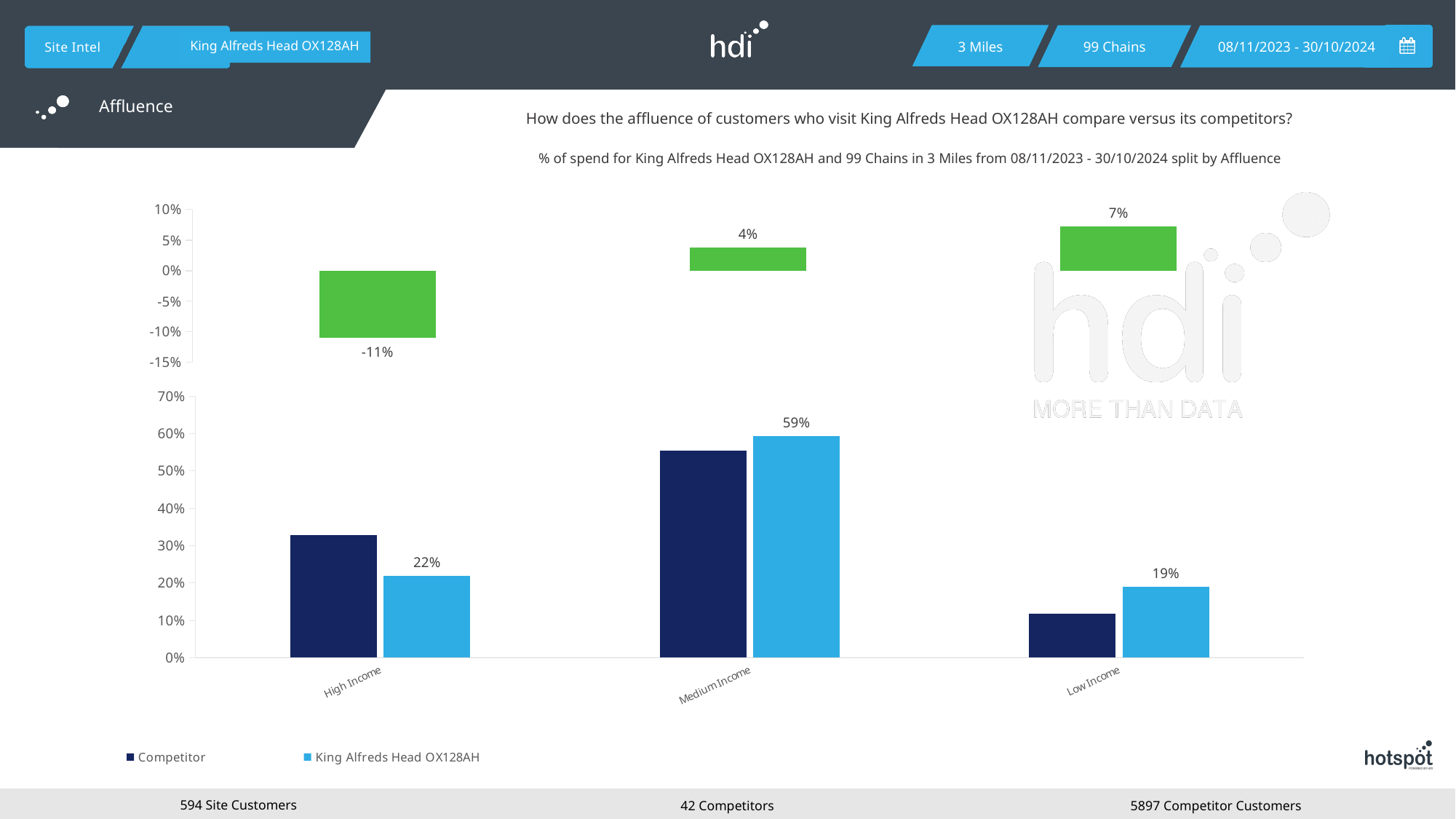
In the bottom bar chart, is the Competitor value for Low Income greater or less than 20%? less In the top chart of green bars, what is the value shown for the Low Income category? 7% How many series does the legend of the bottom bar chart list? 2 In the bottom bar chart, is the Competitor value for High Income greater or less than 30%? greater In the bottom bar chart, what is the difference between the King Alfreds Head OX128AH values for Medium Income and High Income? 37% In the bottom bar chart, what is the value for King Alfreds Head OX128AH in the Low Income category? 19% In the bottom bar chart, which is larger for High Income: the Competitor value or the King Alfreds Head OX128AH value? Competitor In the bottom bar chart, which category has the highest value for King Alfreds Head OX128AH? Medium Income In the top chart of green bars, what is the value shown for the High Income category? -11% In the bottom bar chart, what is the value for King Alfreds Head OX128AH in the High Income category? 22% In the top chart of green bars, which category has the lowest value? High Income In the bottom bar chart, what is the value for King Alfreds Head OX128AH in the Medium Income category? 59%